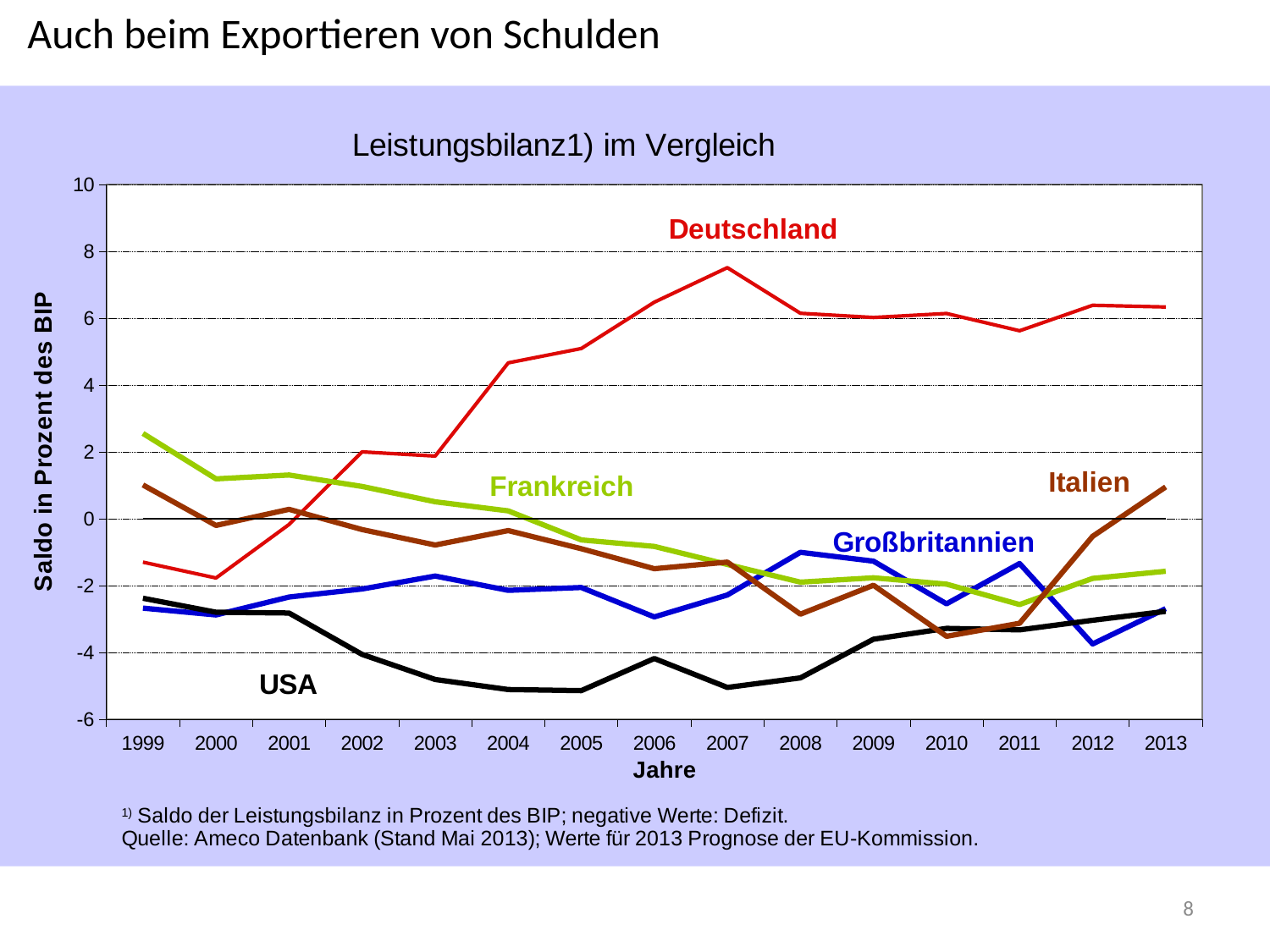
Which country has the highest value in 2013? Deutschland What kind of chart is shown on the slide? line chart Which country has the lowest value in 2007? USA In 2012, which is higher: the value for Italien or the value for Großbritannien? Italien Does the value for USA rise or fall from 2007 to 2013? rise Is the value for USA in 2005 greater or less than -4? less Is the value for Deutschland in 2007 greater or less than 6? greater What is the label of the y axis of the chart? Saldo in Prozent des BIP How many years are plotted along the x axis of the chart? 15 Which country has the highest value in 1999? Frankreich Does the value for Deutschland rise or fall from 1999 to 2007? rise How many countries are plotted as series in the chart? 5